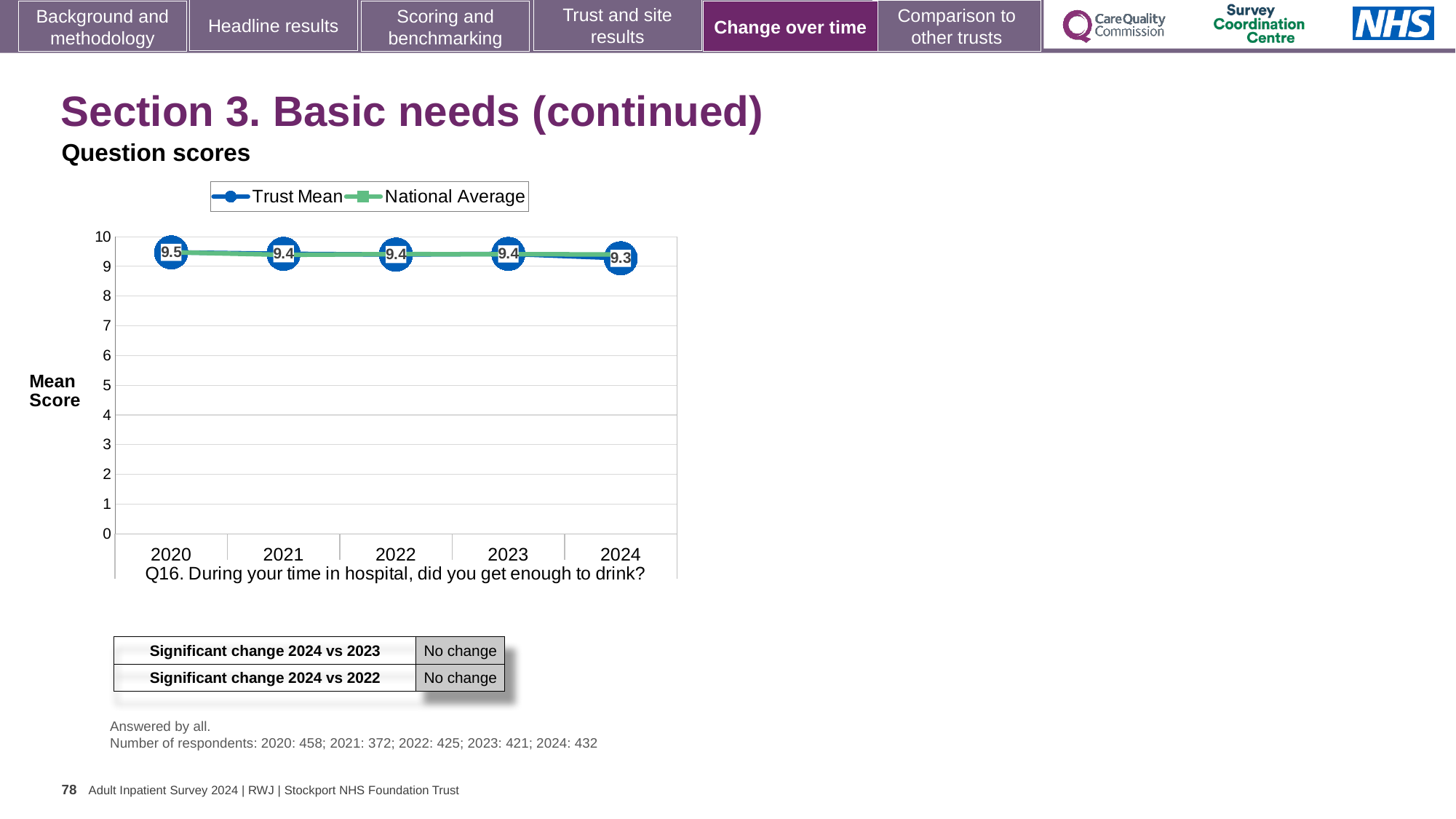
Which is larger, the Trust Mean score for 2020 or for 2024? 2020 What is the Trust Mean score for 2024? 9.3 How many series does the legend list? 2 Is the National Average value for 2022 greater or less than 5? greater What is the Trust Mean score for 2022? 9.4 What is the difference between the Trust Mean score in 2020 and in 2024? 0.2 In which year is the Trust Mean score highest? 2020 What is the Trust Mean score for 2020? 9.5 Does the Trust Mean score rise or fall from 2020 to 2024? Fall What kind of chart is shown on the slide? Line chart How many years are plotted on the x axis? 5 In which year is the Trust Mean score lowest? 2024